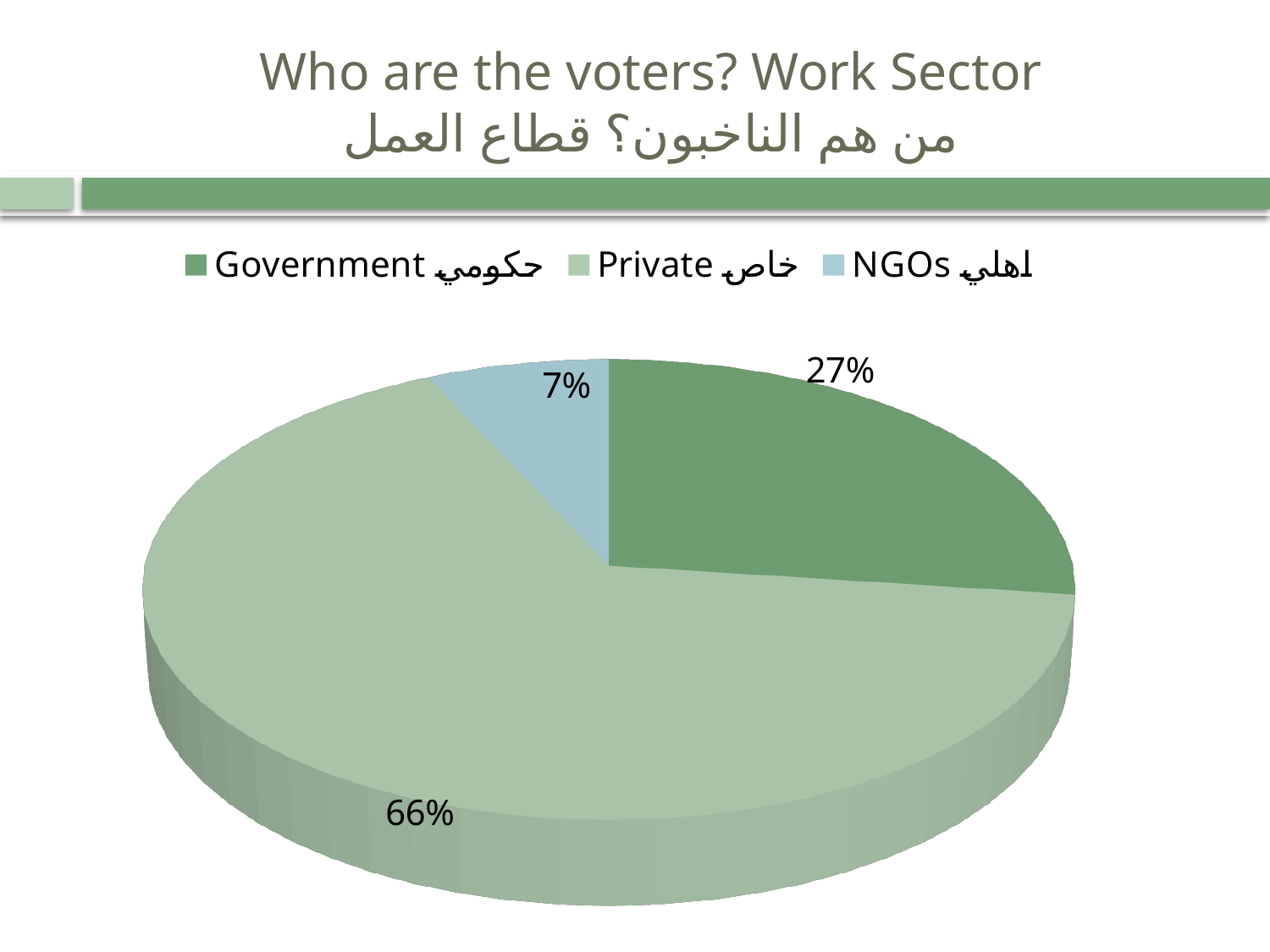
Which is larger, the Government share or the NGOs share? Government What share of voters work in the Government sector? 27% What kind of chart is shown on the slide? Pie chart What is the English title of the slide? Who are the voters? Work Sector What is the difference in percentage points between the Private and Government shares? 39 Which work sector has the smallest share of voters? NGOs How many work sectors are shown in the pie chart? 3 What is the difference in percentage points between the Government and NGOs shares? 20 Which work sector has the largest share of voters? Private What share of voters work in NGOs? 7% How many entries does the legend list? 3 What share of voters work in the Private sector? 66%